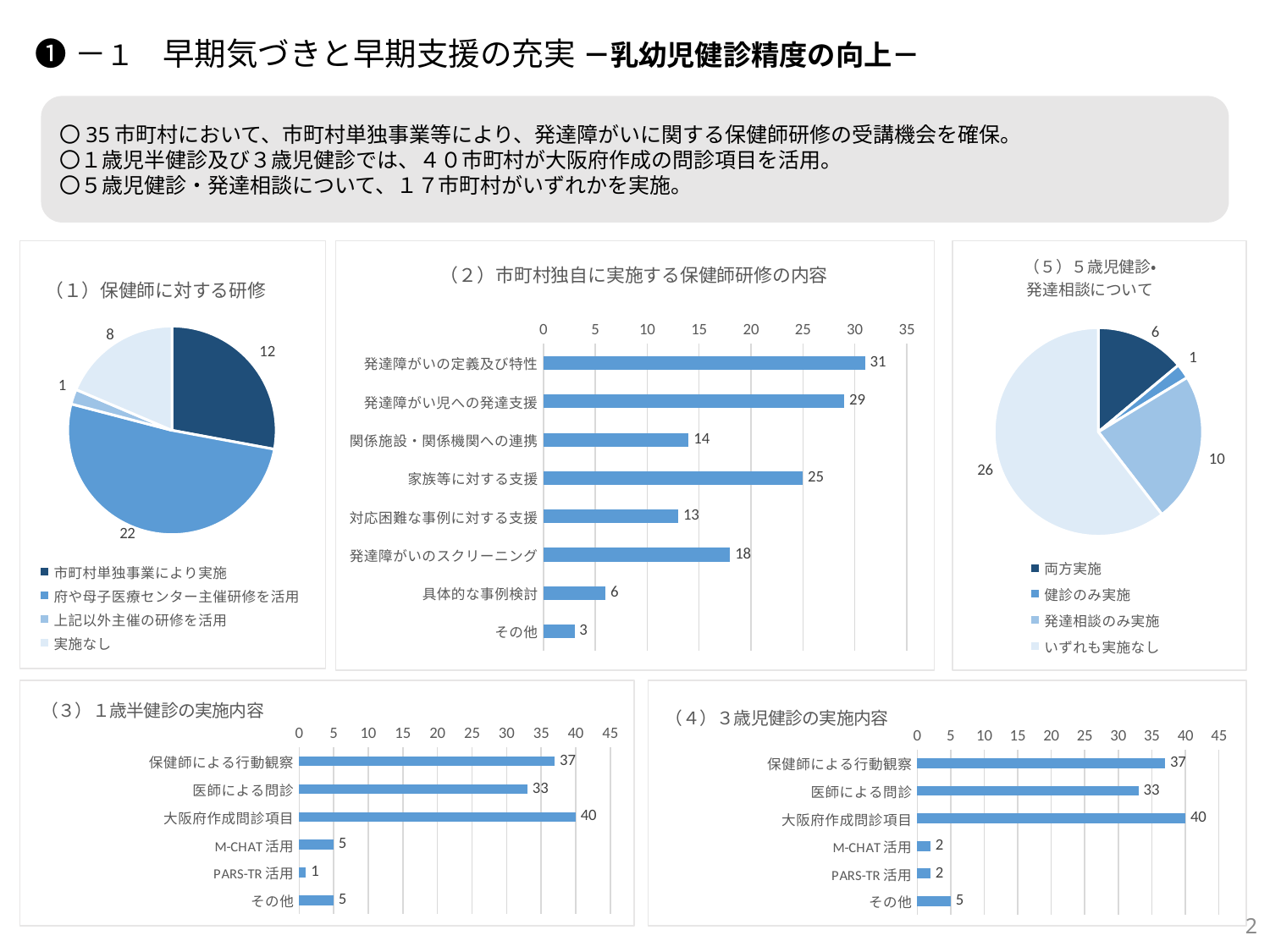
In the chart titled （３）１歳半健診の実施内容, which is larger, 保健師による行動観察 or 医師による問診? 保健師による行動観察 In the pie chart titled （５）５歳児健診・発達相談について, what is the value for いずれも実施なし? 26 In the chart titled （２）市町村独自に実施する保健師研修の内容, what is the difference between 家族等に対する支援 and 対応困難な事例に対する支援? 12 In the chart titled （４）３歳児健診の実施内容, what is the value for M-CHAT 活用? 2 How many series does the legend of the pie chart titled （５）５歳児健診・発達相談について list? 4 In the pie chart titled （１）保健師に対する研修, which category has the largest slice? 府や母子医療センター主催研修を活用 In the chart titled （３）１歳半健診の実施内容, what is the value for PARS-TR 活用? 1 In the chart titled （２）市町村独自に実施する保健師研修の内容, what is the value for 発達障がいの定義及び特性? 31 In the chart titled （２）市町村独自に実施する保健師研修の内容, which category has the lowest value? その他 What kind of chart is （４）３歳児健診の実施内容? bar chart In the pie chart titled （１）保健師に対する研修, what is the value for 府や母子医療センター主催研修を活用? 22 In the chart titled （２）市町村独自に実施する保健師研修の内容, how many categories are plotted? 8